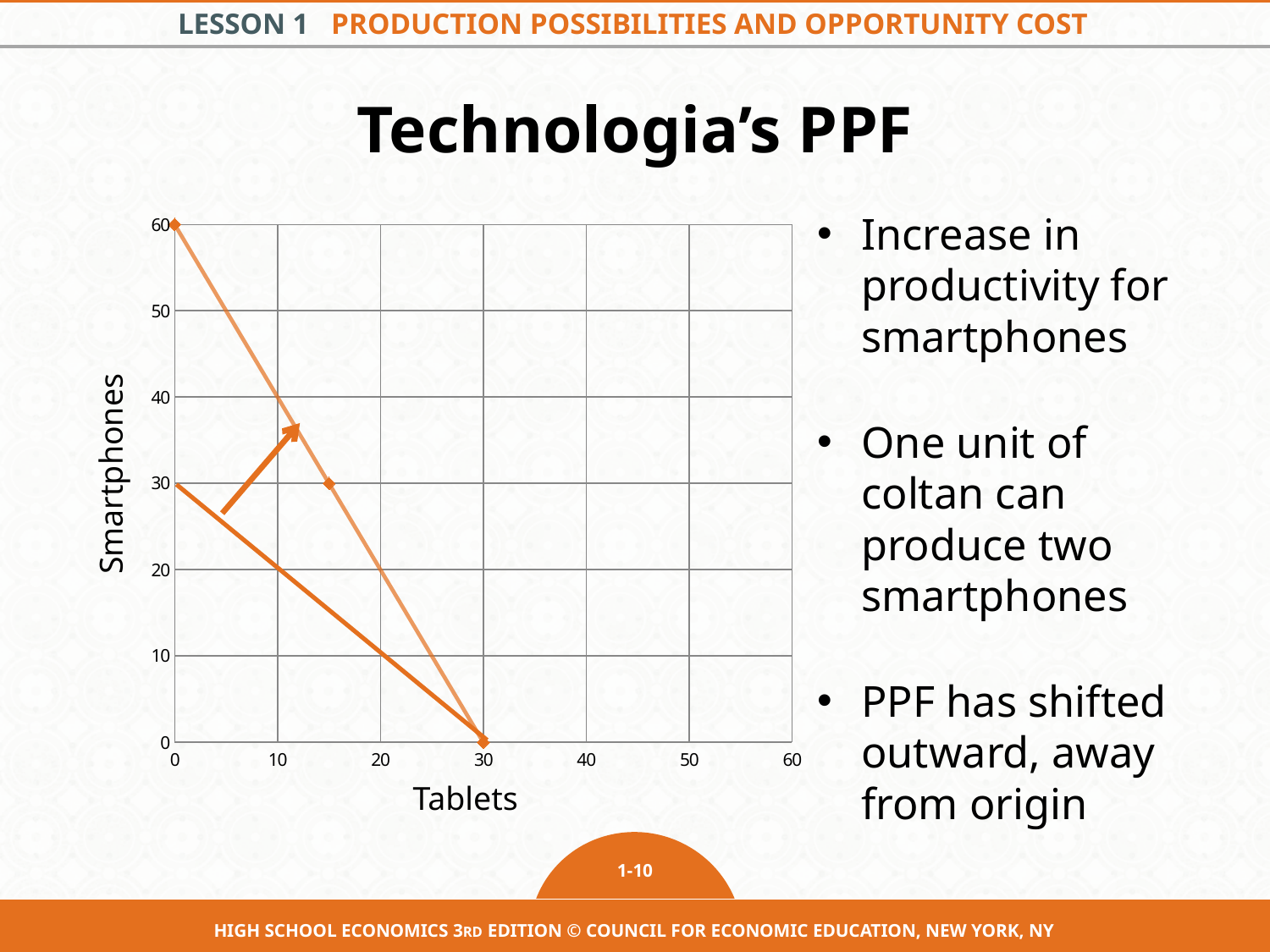
What kind of chart is shown on the slide? line chart What is the difference between the smartphone intercepts of the outer PPF and the inner PPF? 30 On the inner PPF, is the number of smartphones at 10 tablets greater or less than 30? less How many PPF lines are plotted on the chart? 2 What is the label of the horizontal axis? Tablets What is the title of the chart on the slide? Technologia's PPF On the outer (new) PPF, how many smartphones can be produced when 0 tablets are produced? 60 How many tablets can be produced when 0 smartphones are produced? 30 Which PPF has the higher smartphone value at 0 tablets, the outer line or the inner line? the outer line On the outer PPF, is the number of smartphones at 10 tablets greater or less than 30? greater Along each PPF, do smartphones rise or fall as the number of tablets increases? fall On the inner (original) PPF, how many smartphones can be produced when 0 tablets are produced? 30